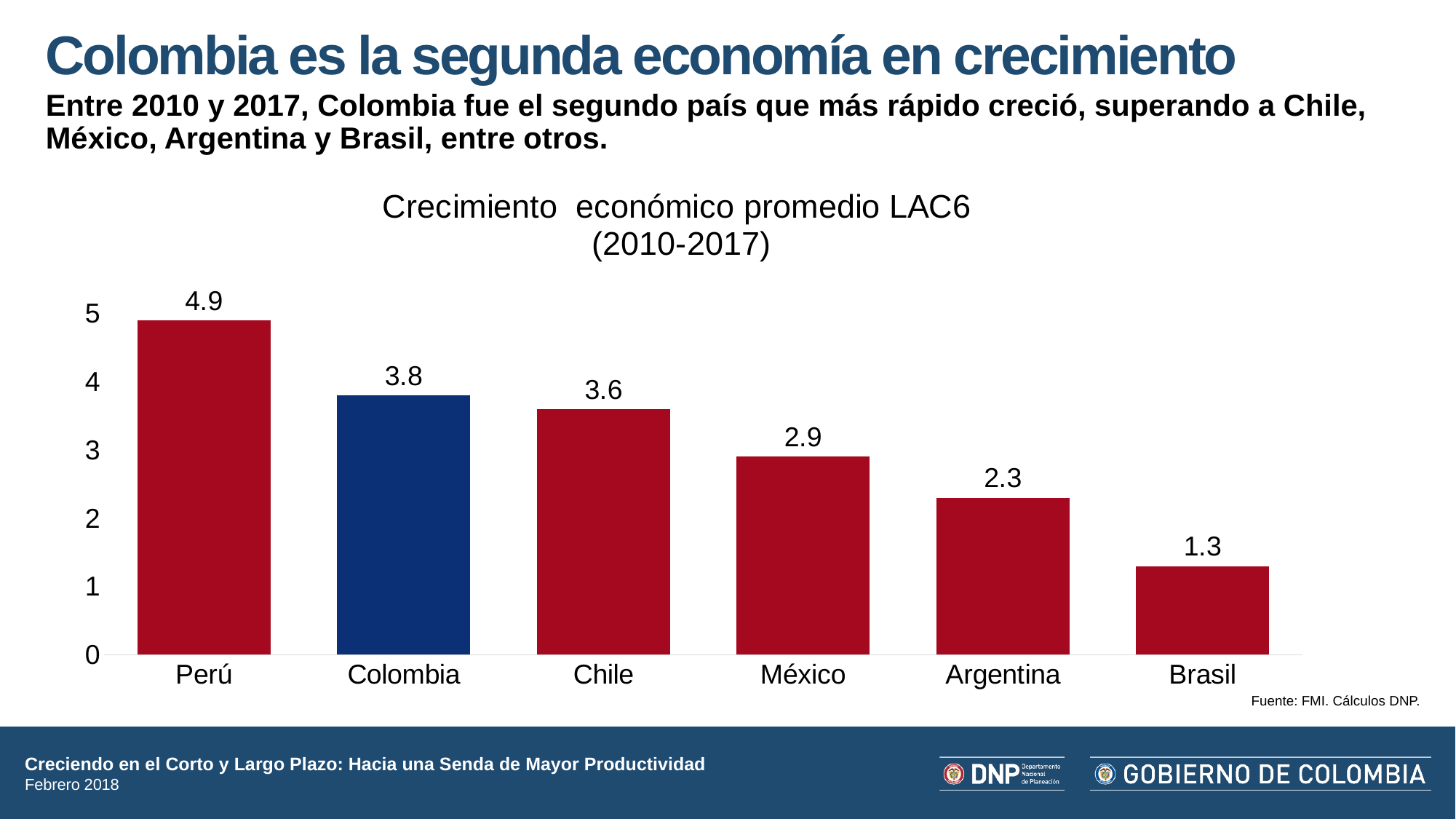
What is the value for México? 2.9 Which bar is coloured differently from the others? Colombia Which country has the highest value? Perú What is the difference between the values for Chile and Argentina? 1.3 Which is larger, the value for Colombia or the value for Chile? Colombia How many countries are shown in the chart? 6 What is the value for Colombia? 3.8 Which country has the lowest value? Brasil What is the difference between the values for Perú and Colombia? 1.1 What is the value for Brasil? 1.3 What kind of chart is shown on the slide? bar chart Is the value for Argentina greater or less than 2? greater